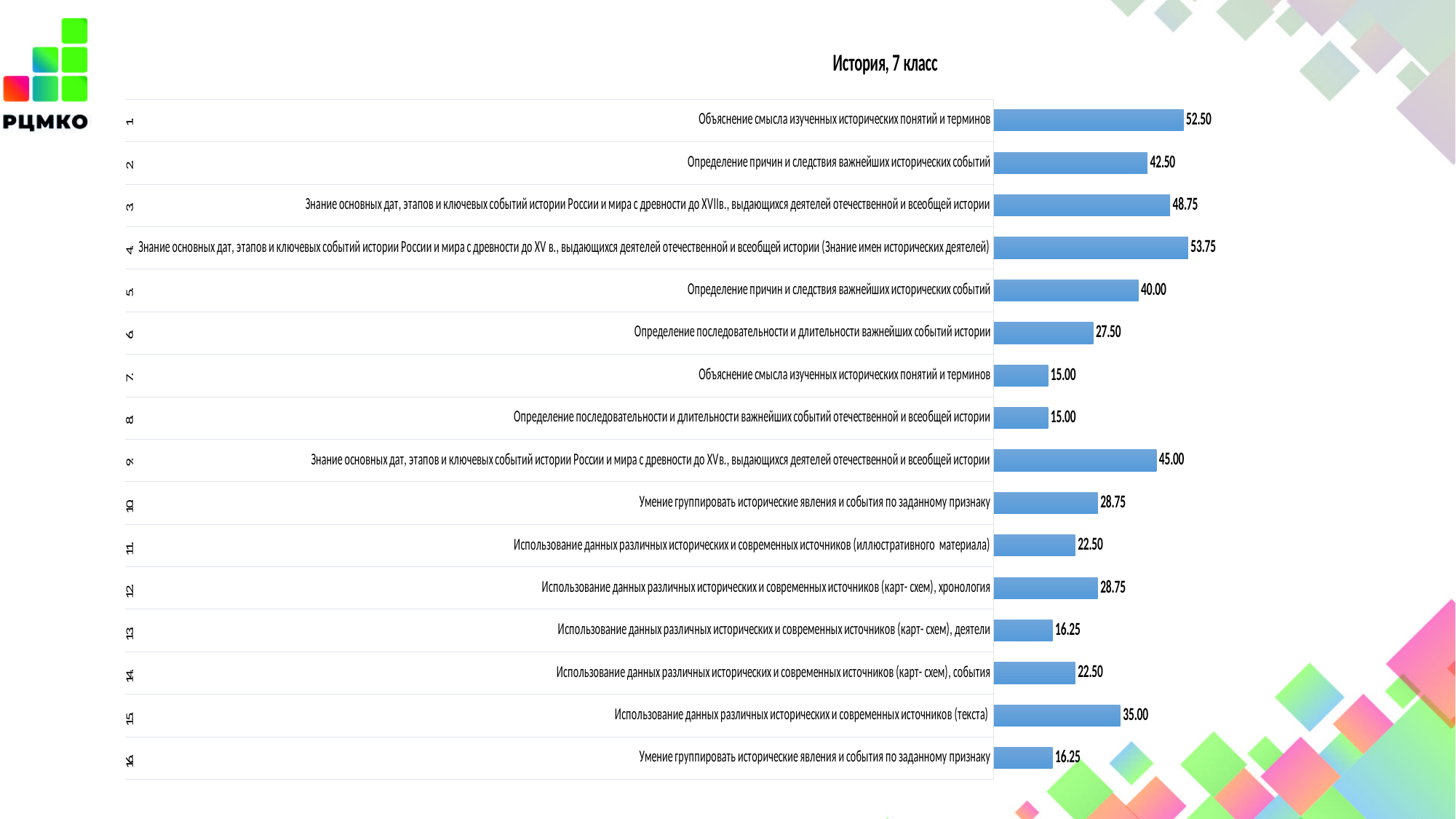
What is the value for item 6 (Определение последовательности и длительности важнейших событий истории)? 27.50 What is the difference between the values for item 1 and item 2? 10.00 What is the value for item 15 (Использование данных различных исторических и современных источников (текста))? 35.00 How many categories (bars) does the chart show? 16 What type of chart is shown on the slide? bar chart Which numbered item has the highest value? 4 Which has a larger value, item 3 or item 9? item 3 What is the value for item 4 (Знание основных дат... Знание имен исторических деятелей)? 53.75 What is the title of the chart? История, 7 класс What is the value for item 13 (Использование данных различных исторических и современных источников (карт- схем), деятели)? 16.25 What is the lowest value shown on the chart? 15.00 What is the difference between the values for item 4 and item 7? 38.75